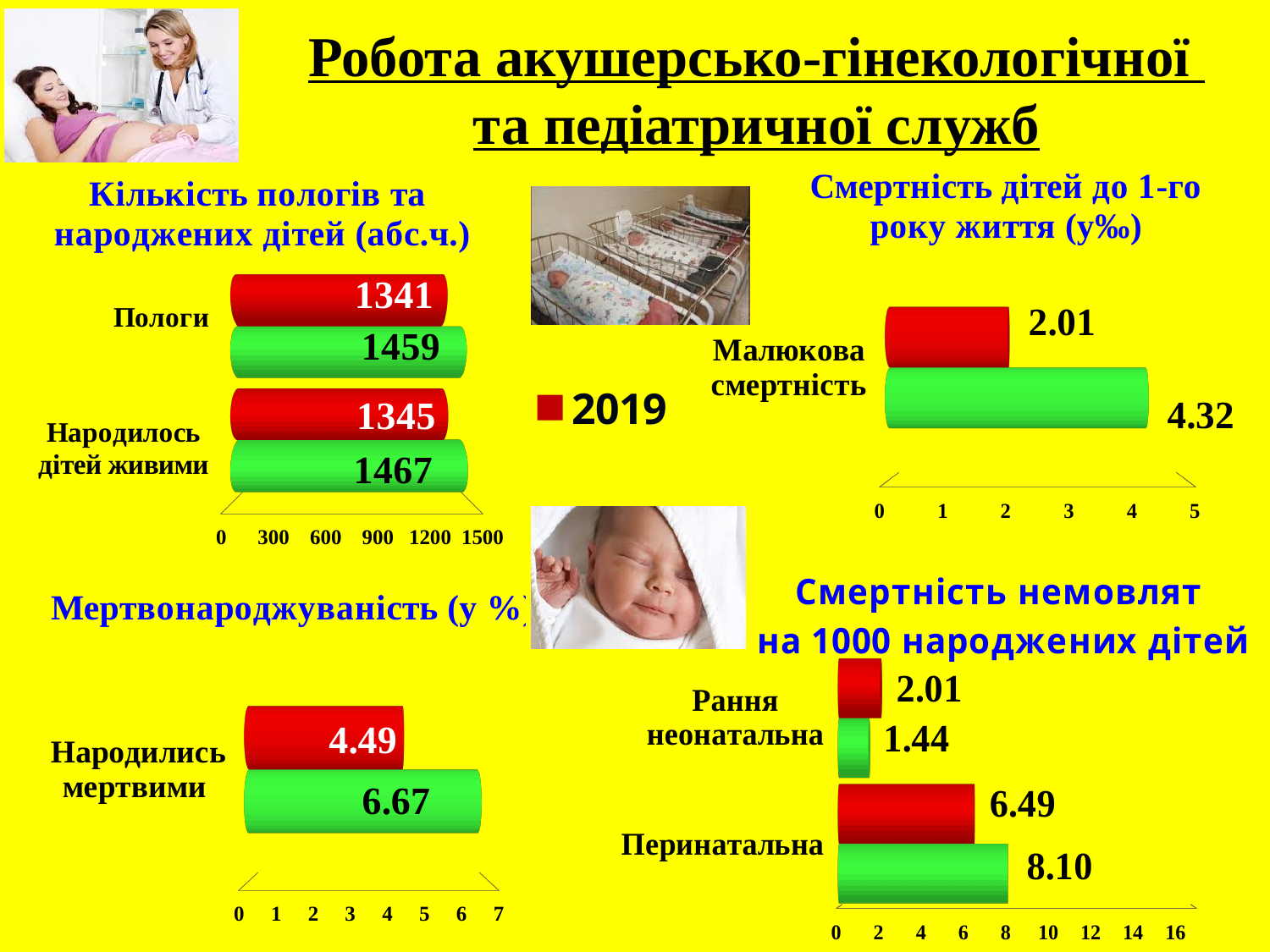
In the chart 'Кількість пологів та народжених дітей (абс.ч.)', what is the 2019 (red) value for 'Пологи'? 1341 In the chart 'Смертність немовлят на 1000 народжених дітей', what is the green bar value for 'Рання неонатальна'? 1.44 In the chart 'Мертвонароджуваність (у %)', what is the 2019 (red) value for 'Народились мертвими'? 4.49 In the chart 'Кількість пологів та народжених дітей (абс.ч.)', what is the green bar value for 'Народилось дітей живими'? 1467 In the chart 'Смертність дітей до 1-го року життя (у‰)', what is the green bar value for 'Малюкова смертність'? 4.32 In the chart 'Мертвонароджуваність (у %)', what is the difference between the green and red bars for 'Народились мертвими'? 2.18 In the chart 'Смертність дітей до 1-го року життя (у‰)', which bar is larger for 'Малюкова смертність', the red (2019) or the green one? green In the chart 'Кількість пологів та народжених дітей (абс.ч.)', how many categories are shown on the axis? 2 In the chart 'Смертність немовлят на 1000 народжених дітей', which category has the highest value? Перинатальна In the chart 'Смертність немовлят на 1000 народжених дітей', what is the 2019 (red) value for 'Перинатальна'? 6.49 What type of chart is used for 'Мертвонароджуваність (у %)'? bar chart In the chart 'Кількість пологів та народжених дітей (абс.ч.)', what is the difference between the green and red bars for 'Пологи'? 118